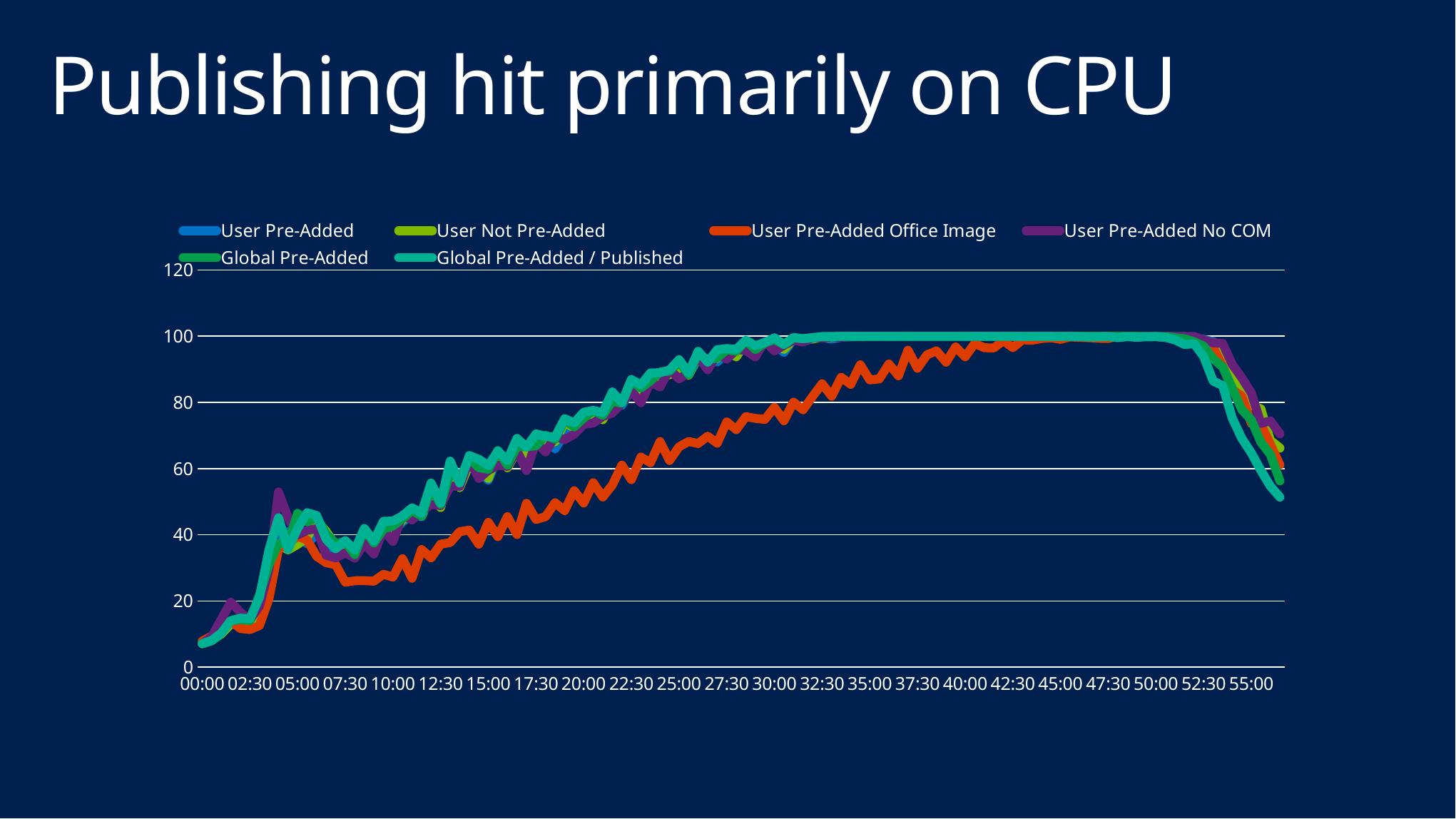
What kind of chart is shown on the slide? line chart What is the title of the slide containing the chart? Publishing hit primarily on CPU Between 07:30 and 40:00, do the values for User Pre-Added Office Image generally rise or fall? rise Is the value for User Pre-Added Office Image at 10:00 greater or less than 40? less Between 50:00 and 55:00, do the values for Global Pre-Added / Published rise or fall? fall Is the value for User Pre-Added Office Image at 25:00 greater or less than 40? greater Is the value for User Pre-Added No COM at 00:00 greater or less than 20? less Which series is drawn in orange-red in the chart? User Pre-Added Office Image At 25:00, which series is higher: Global Pre-Added / Published or User Pre-Added Office Image? Global Pre-Added / Published What is the highest value shown on the y axis? 120 How many series does the legend list? 6